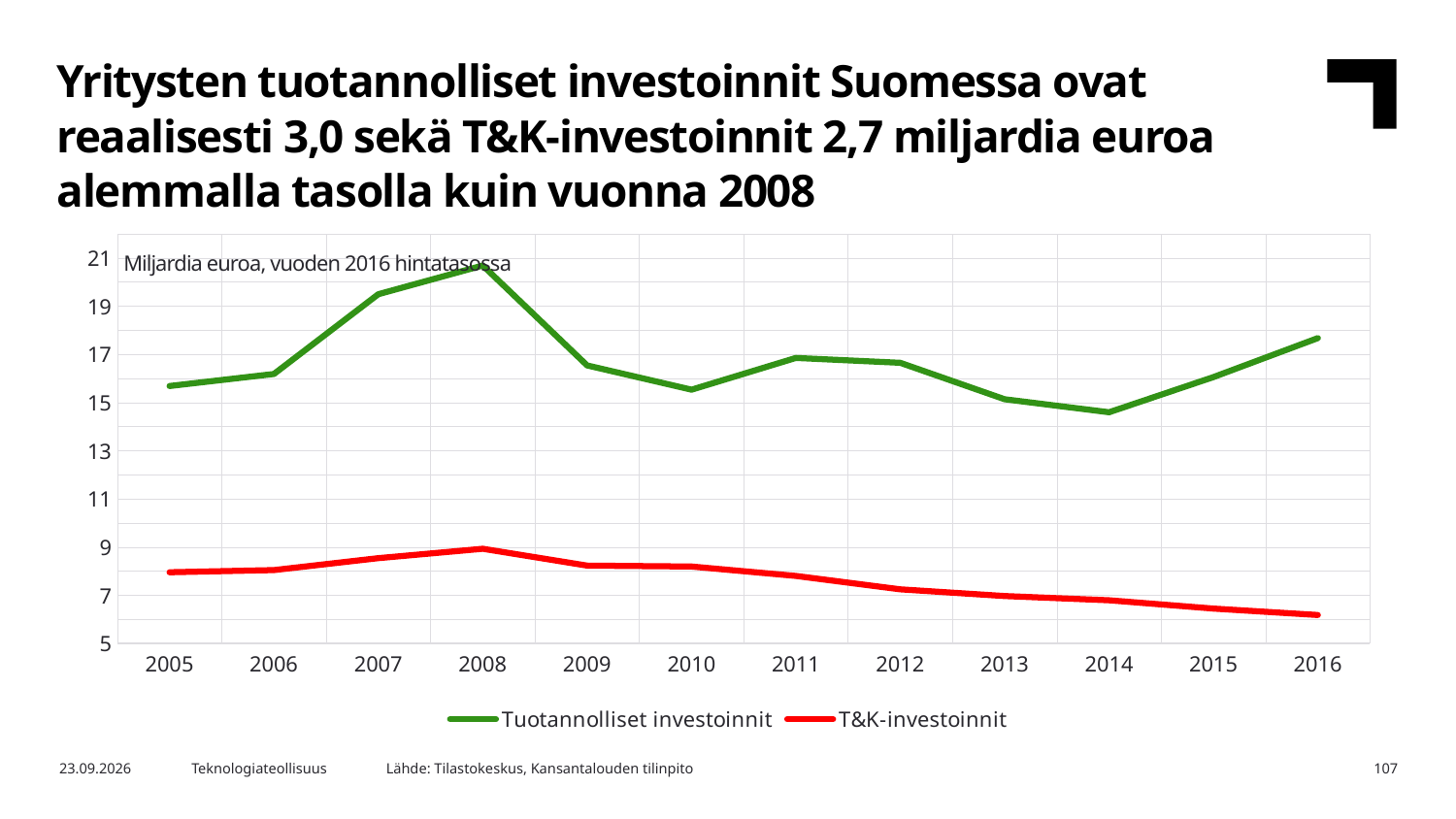
In which year is Tuotannolliset investoinnit at its highest? 2008 Which series has the larger value in 2010, Tuotannolliset investoinnit or T&K-investoinnit? Tuotannolliset investoinnit How many series does the legend list? 2 What kind of chart is shown on the slide? line chart In which year is Tuotannolliset investoinnit at its lowest? 2014 Is the value for Tuotannolliset investoinnit in 2008 greater or less than 19? greater What unit label is shown inside the chart area? Miljardia euroa, vuoden 2016 hintatasossa Is the value for T&K-investoinnit in 2016 greater or less than 7? less Does T&K-investoinnit rise or fall from 2008 to 2016? fall How many years are plotted along the x axis? 12 In which year is T&K-investoinnit at its lowest? 2016 In which year is T&K-investoinnit at its highest? 2008